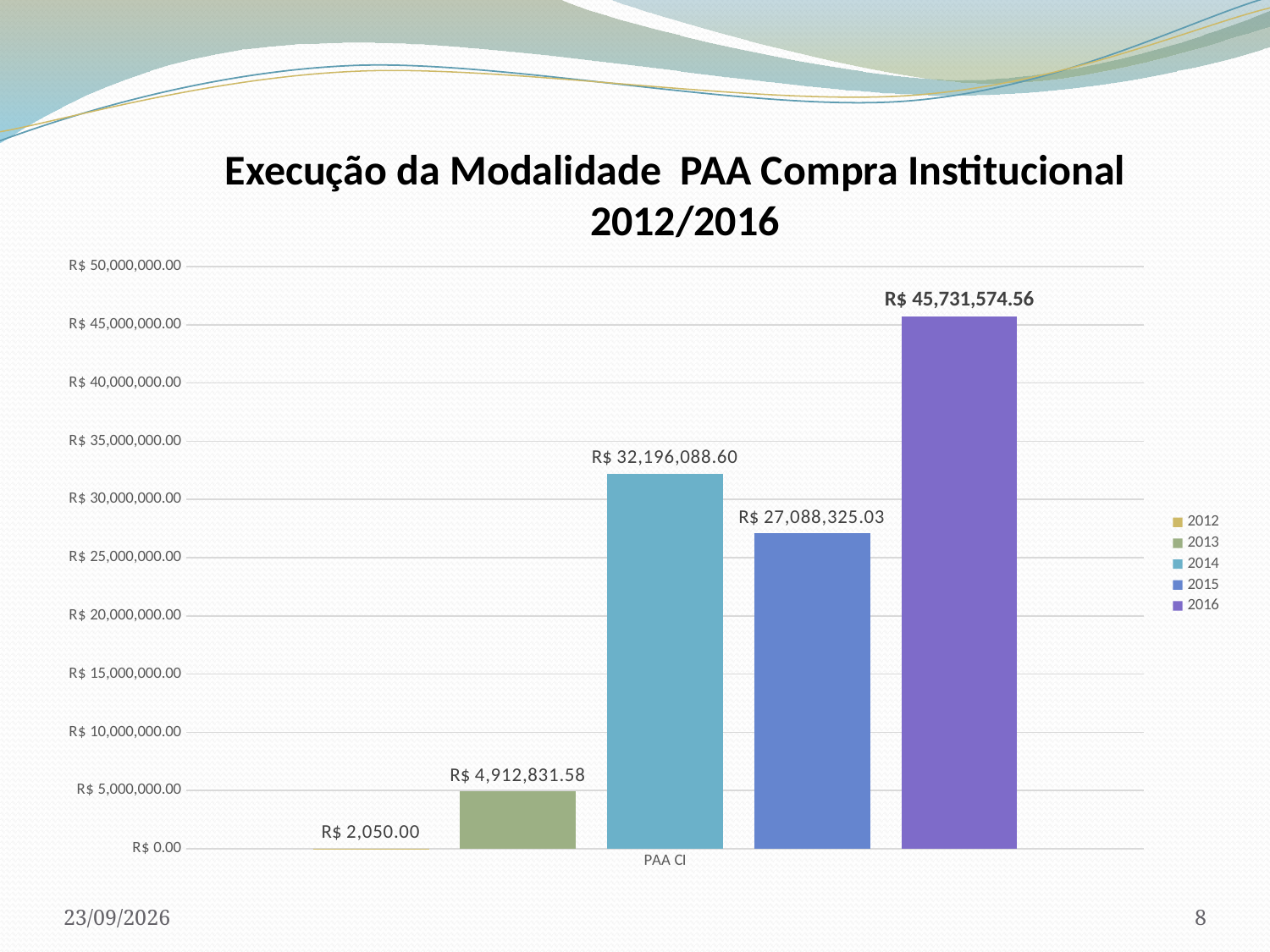
What kind of chart is shown on the slide? Bar chart Which is larger, the value for 2014 or the value for 2015? 2014 What is the value for 2012 in the chart? R$ 2,050.00 What is the difference between the values for 2014 and 2015? R$ 5,107,763.57 What is the value for 2013 in the chart? R$ 4,912,831.58 What is the value for 2016 in the chart? R$ 45,731,574.56 What is the value for 2014 in the chart? R$ 32,196,088.60 Which year has the lowest value in the chart? 2012 What is the title of the chart? Execução da Modalidade PAA Compra Institucional 2012/2016 How many series does the legend list? 5 Which year has the highest value in the chart? 2016 What is the difference between the values for 2016 and 2014? R$ 13,535,485.96